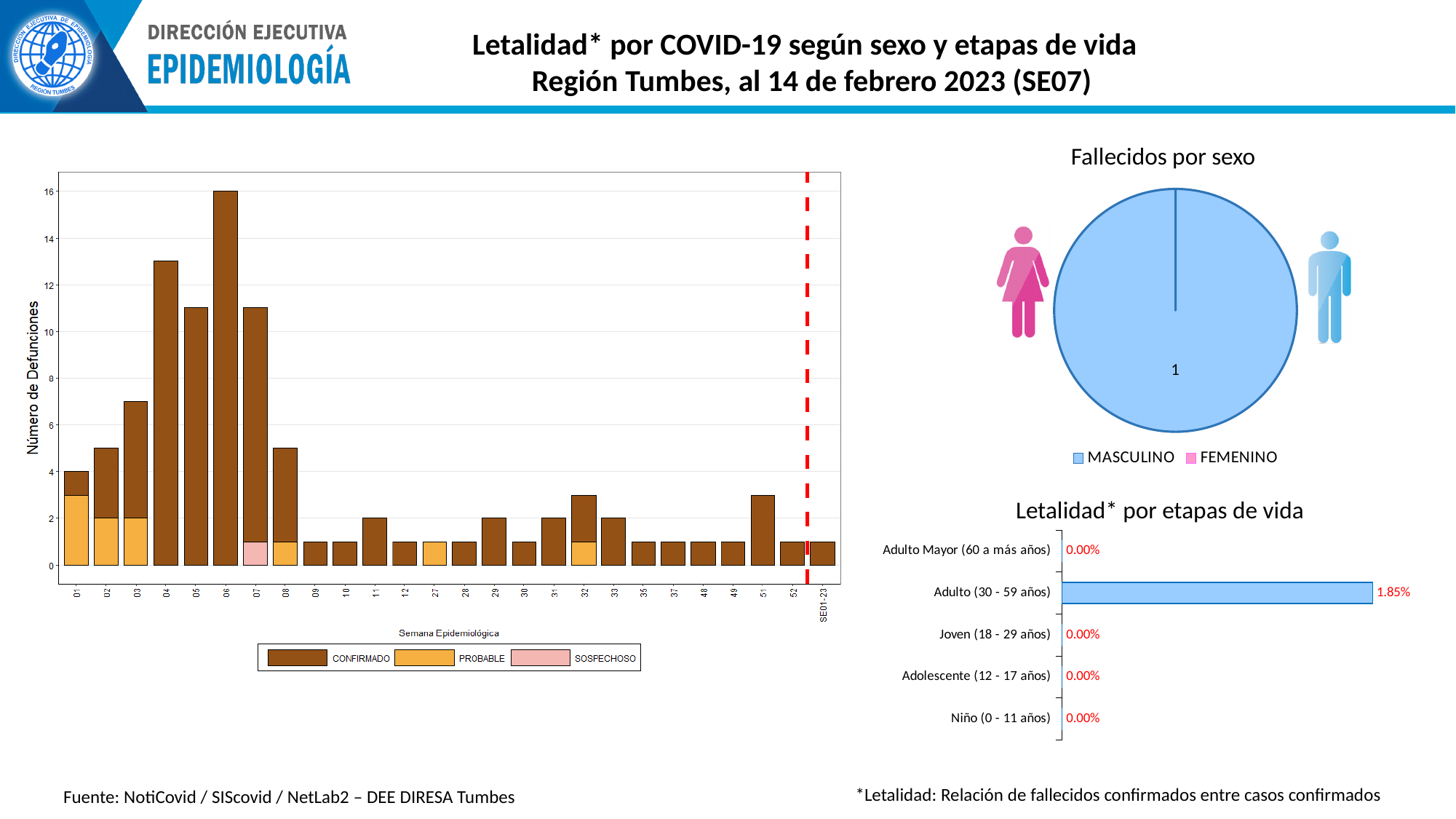
In the bar chart on the left (Número de Defunciones by Semana Epidemiológica), which week has the highest number of deaths? 06 In the bar chart on the left, what kind of chart is it? stacked bar chart In the bar chart on the left, which is larger: the bar for week 06 or the bar for week 04? week 06 In the 'Fallecidos por sexo' pie chart, how many categories does the legend list? 2 In the 'Letalidad* por etapas de vida' chart, what is the value for Adulto (30 - 59 años)? 1.85% In the bar chart on the left, is the value for week 04 greater or less than 12? greater In the 'Letalidad* por etapas de vida' chart, which age group has the highest lethality? Adulto (30 - 59 años) In the 'Letalidad* por etapas de vida' chart, how many age groups are shown? 5 In the bar chart on the left, what is the total number of deaths in week 06? 16 In the 'Fallecidos por sexo' pie chart, what value is shown for MASCULINO? 1 In the bar chart on the left, which series is shown in pink? SOSPECHOSO In the bar chart on the left, how many series does the legend list? 3